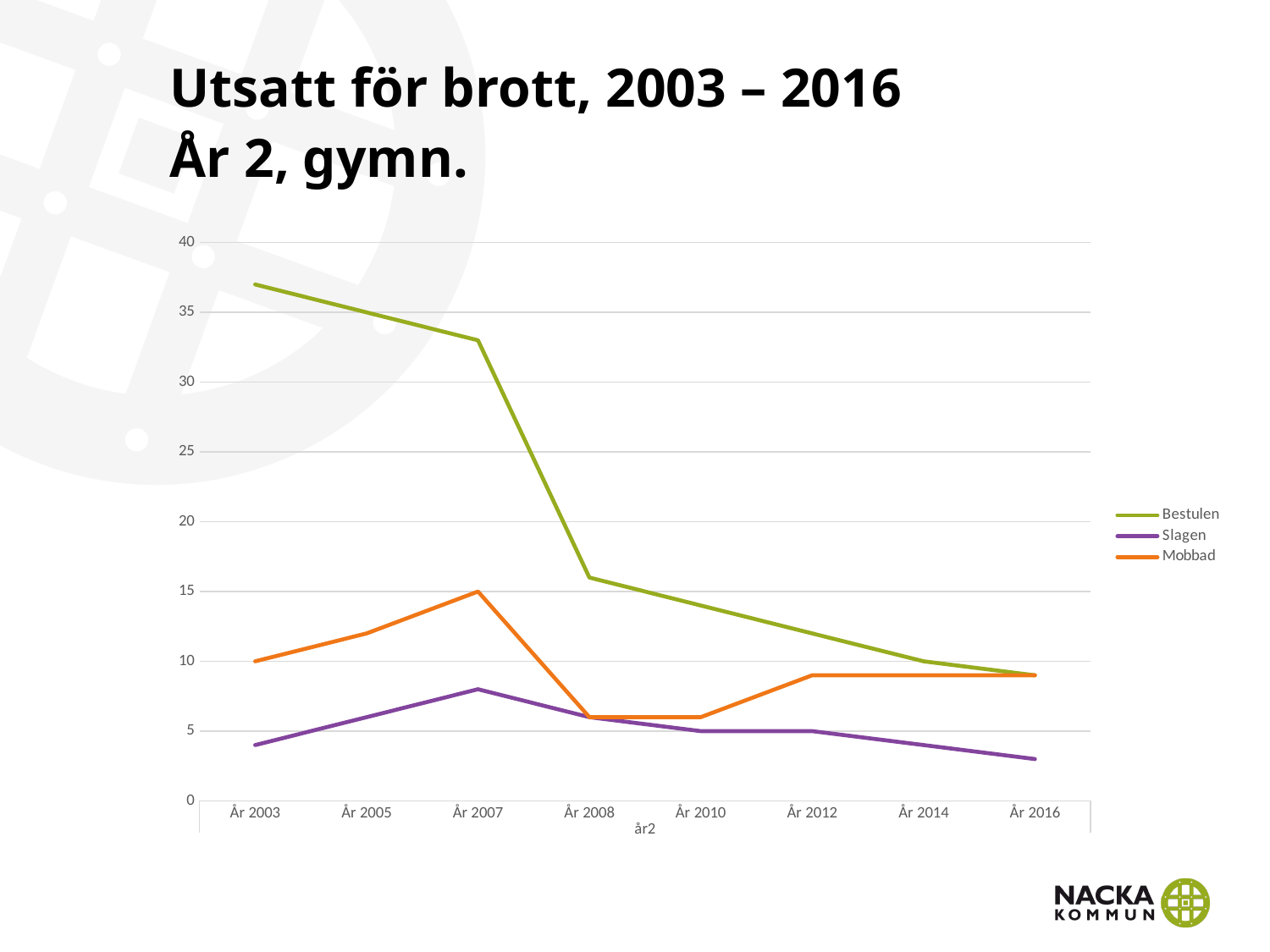
Is the value for Slagen in År 2016 greater or less than 5? less What is the value for Mobbad in År 2003? 10 What is the value for Slagen in År 2010? 5 What kind of chart is shown on the slide? line chart How many series does the legend list? 3 In which year is the Bestulen series at its highest? År 2003 What is the value for Mobbad in År 2007? 15 Is the value for Bestulen in År 2003 greater or less than 35? greater In År 2007, which is larger: Bestulen or Mobbad? Bestulen How many years are shown on the x axis? 8 In which year is the Slagen series at its lowest? År 2016 Does the Bestulen series rise or fall from År 2003 to År 2016? fall